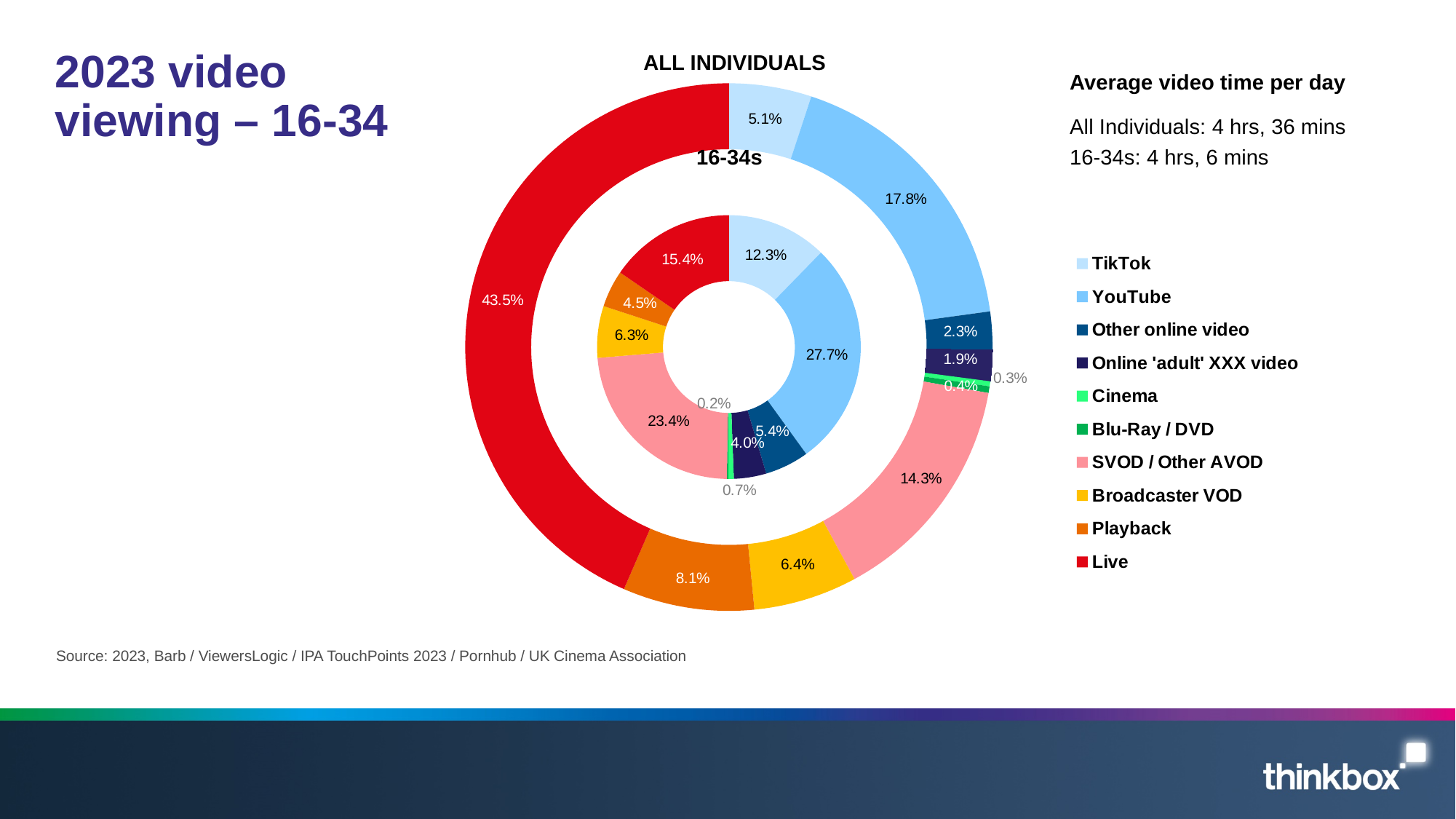
How many categories does the legend list? 10 What is the difference between the Live share for ALL INDIVIDUALS (43.5%) and for 16-34s (15.4%)? 28.1% Which category has the largest share in the ALL INDIVIDUALS ring? Live In the ALL INDIVIDUALS ring, what share is SVOD / Other AVOD? 14.3% According to the slide, what is the average video time per day for 16-34s? 4 hrs, 6 mins In the ALL INDIVIDUALS ring, what share of video viewing is Live? 43.5% What type of chart is shown on the slide? Doughnut chart In the 16-34s ring, what share of video viewing is TikTok? 12.3% In the 16-34s ring, what share of video viewing is YouTube? 27.7% Which category has the largest share in the 16-34s ring? YouTube In the ALL INDIVIDUALS ring, what share is Playback? 8.1% Which is larger: the YouTube share for 16-34s or the YouTube share for ALL INDIVIDUALS? 16-34s